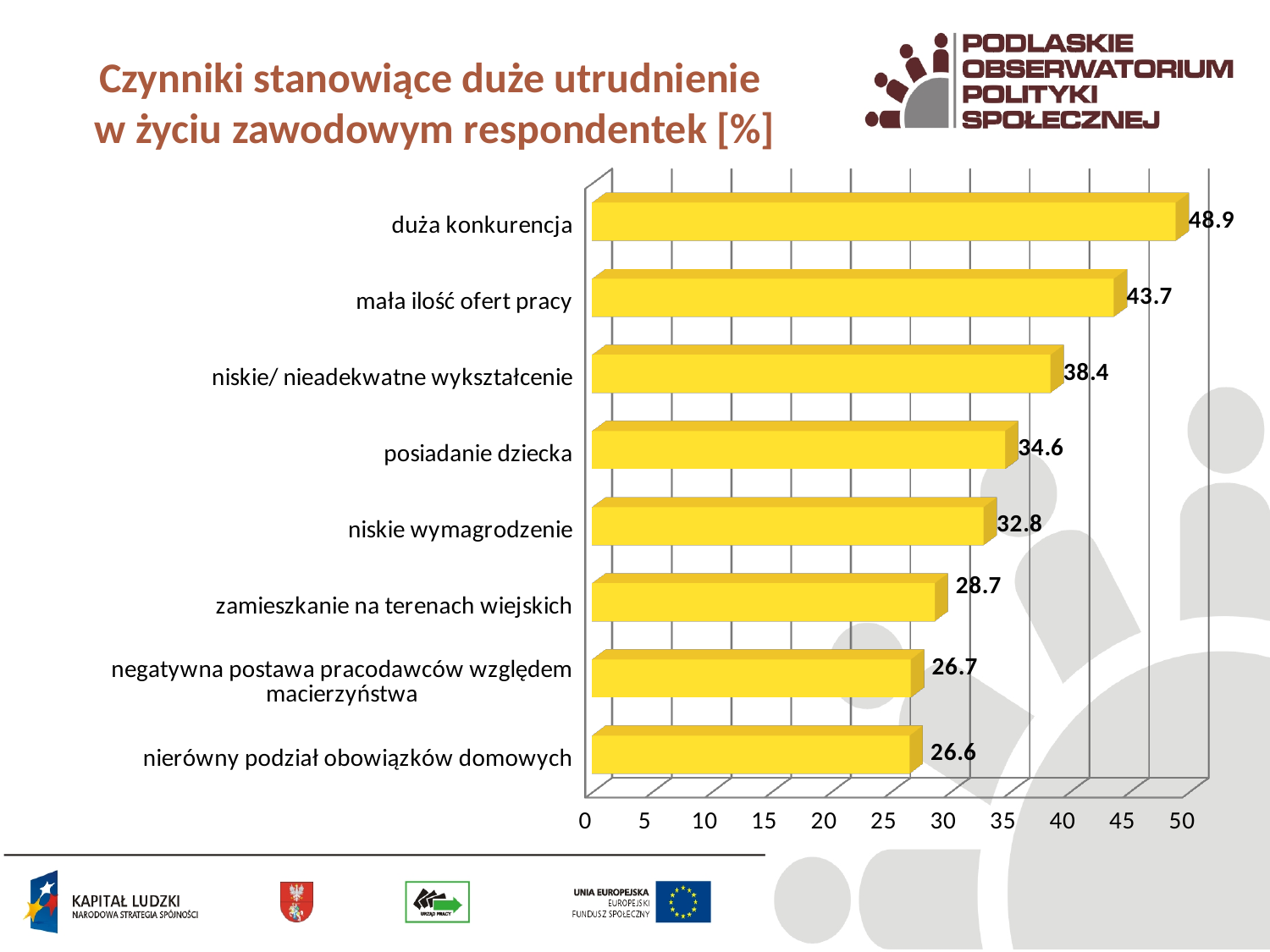
How many categories are shown in the chart? 8 Which category has the highest value? duża konkurencja What kind of chart is shown on the slide? bar chart What is the value for "nierówny podział obowiązków domowych"? 26.6 What is the difference between the values for "duża konkurencja" and "mała ilość ofert pracy"? 5.2 Which is larger: the value for "niskie/ nieadekwatne wykształcenie" or the value for "niskie wymagrodzenie"? niskie/ nieadekwatne wykształcenie Is the value for "mała ilość ofert pracy" greater or less than 40? greater What is the value for "posiadanie dziecka"? 34.6 Which category has the lowest value? nierówny podział obowiązków domowych What is the value for "duża konkurencja"? 48.9 What is the value for "zamieszkanie na terenach wiejskich"? 28.7 What is the difference between the values for "posiadanie dziecka" and "niskie wymagrodzenie"? 1.8